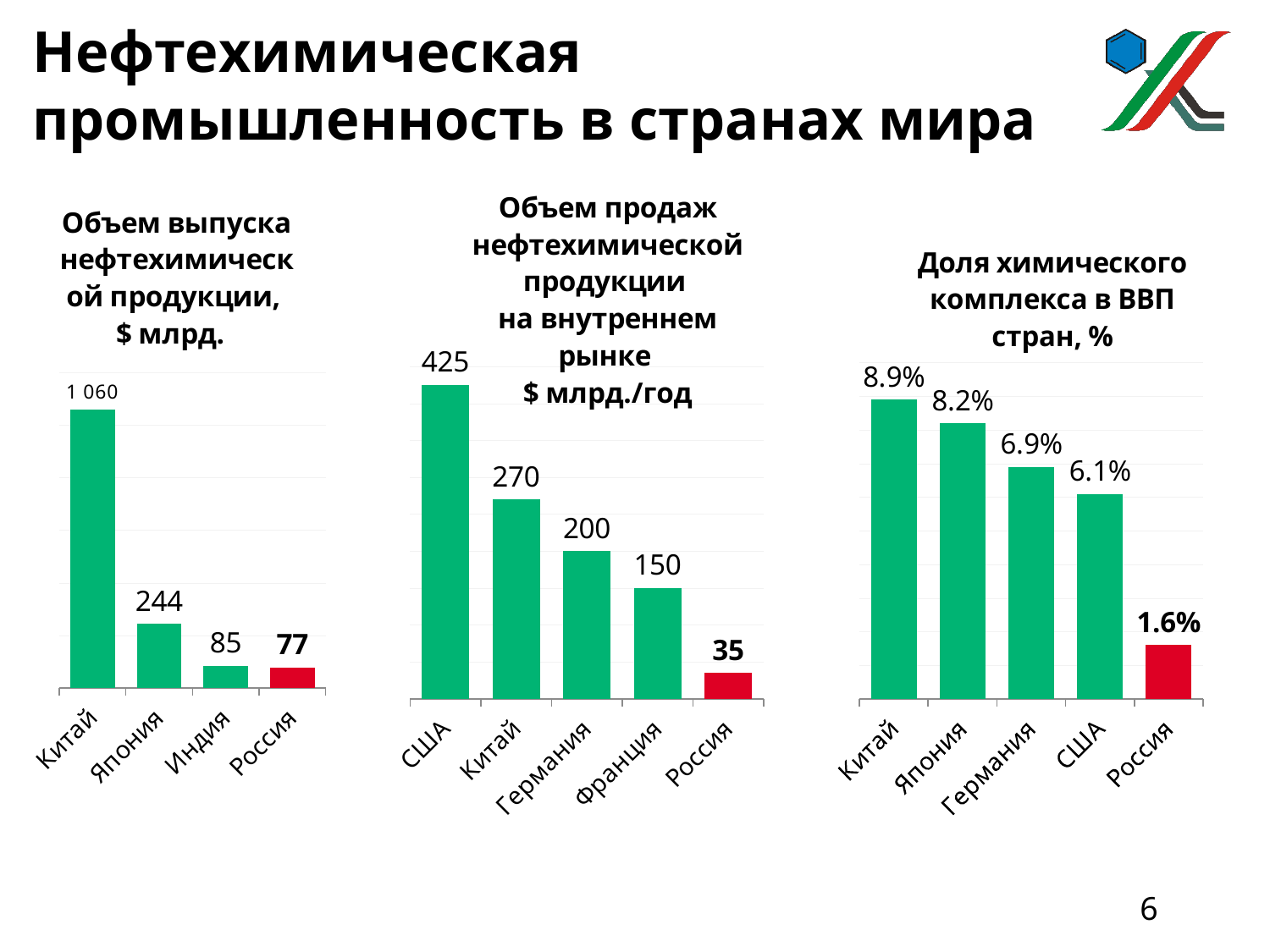
In the middle chart (Объем продаж нефтехимической продукции на внутреннем рынке), what is the difference between Китай and Германия? 70 In the left chart (Объем выпуска нефтехимической продукции, $ млрд.), what is the difference between Япония and Индия? 159 In the left chart (Объем выпуска нефтехимической продукции, $ млрд.), which country has the lowest value? Россия In the right chart (Доля химического комплекса в ВВП стран, %), which is larger, Германия or США? Германия In the middle chart (Объем продаж нефтехимической продукции на внутреннем рынке), what is the value for Франция? 150 In the right chart (Доля химического комплекса в ВВП стран, %), which country has the highest value? Китай In the left chart (Объем выпуска нефтехимической продукции, $ млрд.), what is the value for Китай? 1 060 What type of chart is the right chart (Доля химического комплекса в ВВП стран, %)? Bar chart In the right chart (Доля химического комплекса в ВВП стран, %), what is the value for Япония? 8.2% In the middle chart (Объем продаж нефтехимической продукции на внутреннем рынке), what is the value for США? 425 In the left chart (Объем выпуска нефтехимической продукции, $ млрд.), what is the value for Россия? 77 In the middle chart (Объем продаж нефтехимической продукции на внутреннем рынке), how many countries are shown? 5